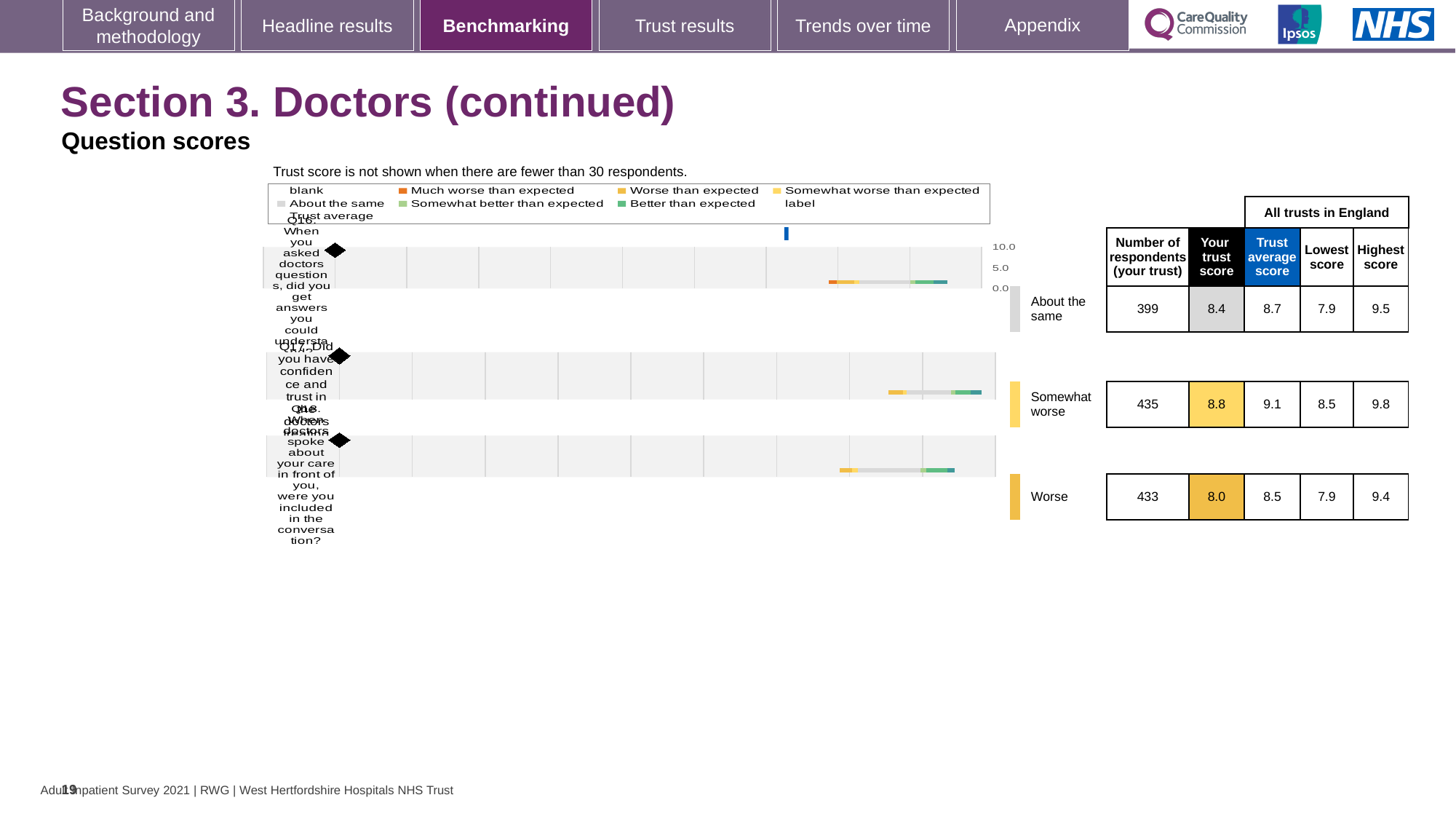
Which is larger: the number of respondents for Q17 or for Q18? Q17 What is the difference between the trust average score and this trust's score for Q16? 0.3 What is the highest score across all trusts in England for Q17? 9.8 Which question has the lowest trust score for this trust? Q18 What benchmark category is shown for Q18? Worse How many respondents answered Q17 at this trust? 435 What is the trust score for Q16 (When you asked doctors questions, did you get answers you could understand?)? 8.4 What is the trust score for Q18 (When doctors spoke about your care in front of you, were you included in the conversation?)? 8.0 What is the trust average score across all trusts in England for Q18? 8.5 Which question has the highest trust score for this trust? Q17 How many questions are plotted on the chart? 3 What is the trust score for Q17 (Did you have confidence and trust in the doctors treating you?)? 8.8